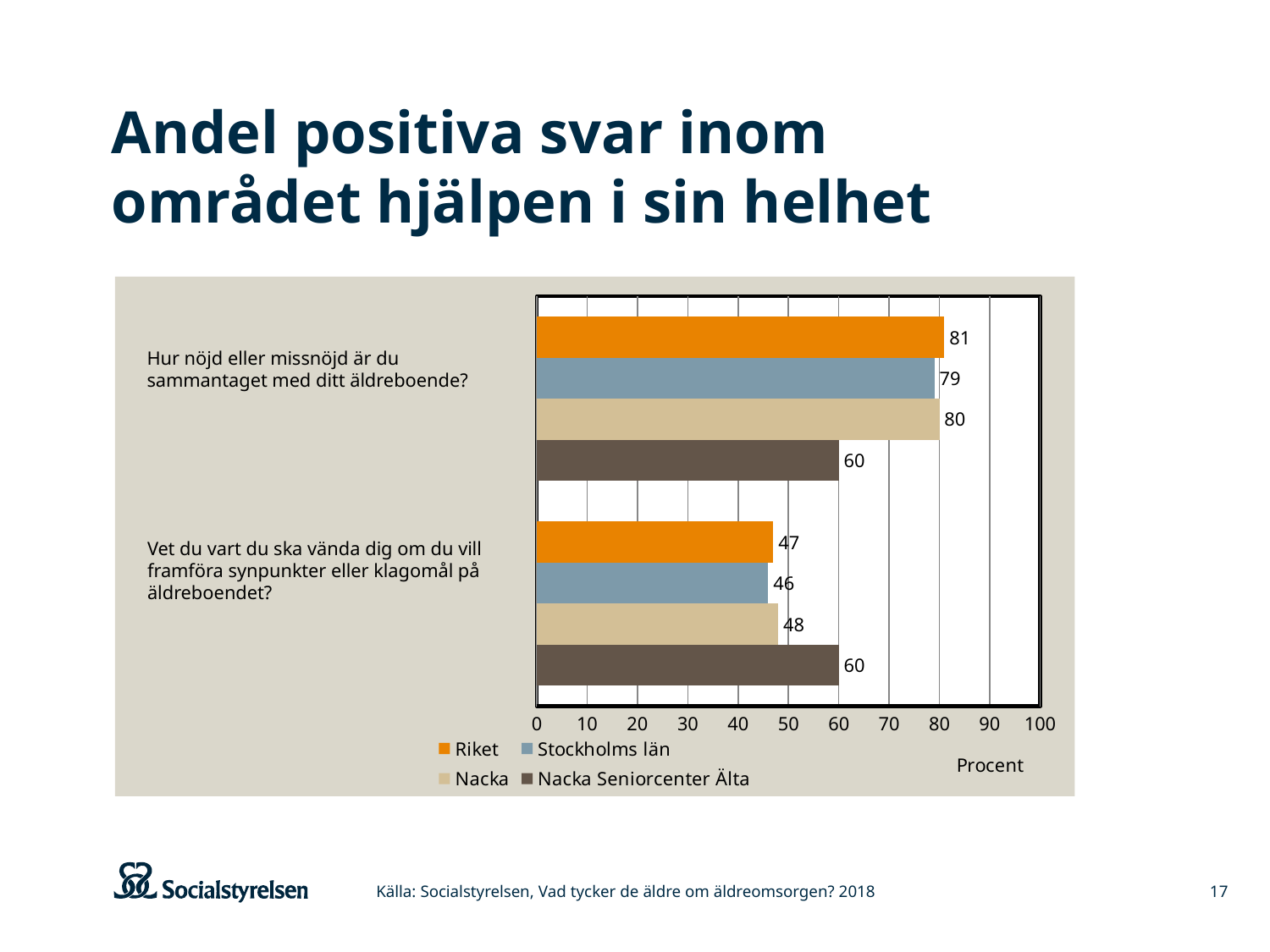
What kind of chart is shown on the slide? Bar chart What is the value for Riket on the question "Hur nöjd eller missnöjd är du sammantaget med ditt äldreboende?"? 81 How many questions (categories) are shown on the chart? 2 What unit label is shown on the horizontal axis of the chart? Procent What is the difference between the Riket value and the Nacka Seniorcenter Älta value on the question "Hur nöjd eller missnöjd är du sammantaget med ditt äldreboende?"? 21 What is the value for Stockholms län on the question "Vet du vart du ska vända dig om du vill framföra synpunkter eller klagomål på äldreboendet?"? 46 Which series has the lowest value on the question "Vet du vart du ska vända dig om du vill framföra synpunkter eller klagomål på äldreboendet?"? Stockholms län What is the value for Nacka Seniorcenter Älta on the question "Vet du vart du ska vända dig om du vill framföra synpunkter eller klagomål på äldreboendet?"? 60 What is the value for Nacka on the question "Hur nöjd eller missnöjd är du sammantaget med ditt äldreboende?"? 80 Which series has the highest value on the question "Hur nöjd eller missnöjd är du sammantaget med ditt äldreboende?"? Riket Which is larger on the question "Vet du vart du ska vända dig om du vill framföra synpunkter eller klagomål på äldreboendet?": the value for Nacka or the value for Nacka Seniorcenter Älta? Nacka Seniorcenter Älta How many series does the legend list? 4